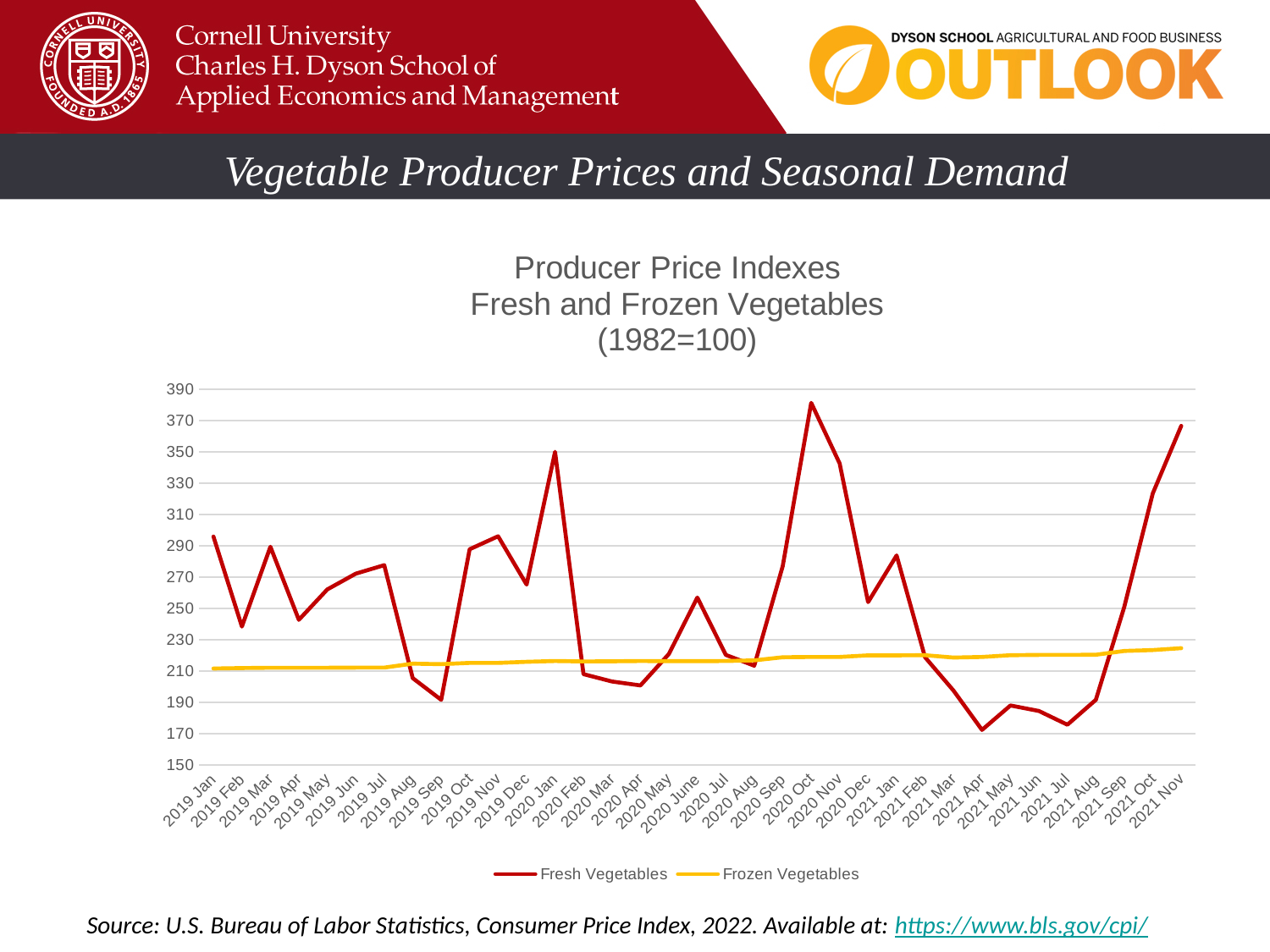
What kind of chart is shown on the slide? line chart In 2021 Apr, which series has the larger value, Fresh Vegetables or Frozen Vegetables? Frozen Vegetables Is the Fresh Vegetables value for 2019 Sep greater or less than 210? less In which month does the Fresh Vegetables index reach its highest value? 2020 Oct What are the two series named in the legend? Fresh Vegetables and Frozen Vegetables How many series does the legend list? 2 Is the Frozen Vegetables value for 2021 Nov greater or less than 230? less Is the Fresh Vegetables value for 2021 Apr greater or less than 190? less How many months are plotted along the x axis? 35 Which series is drawn in red? Fresh Vegetables Does the Frozen Vegetables index generally rise or fall from 2019 Jan to 2021 Nov? rise